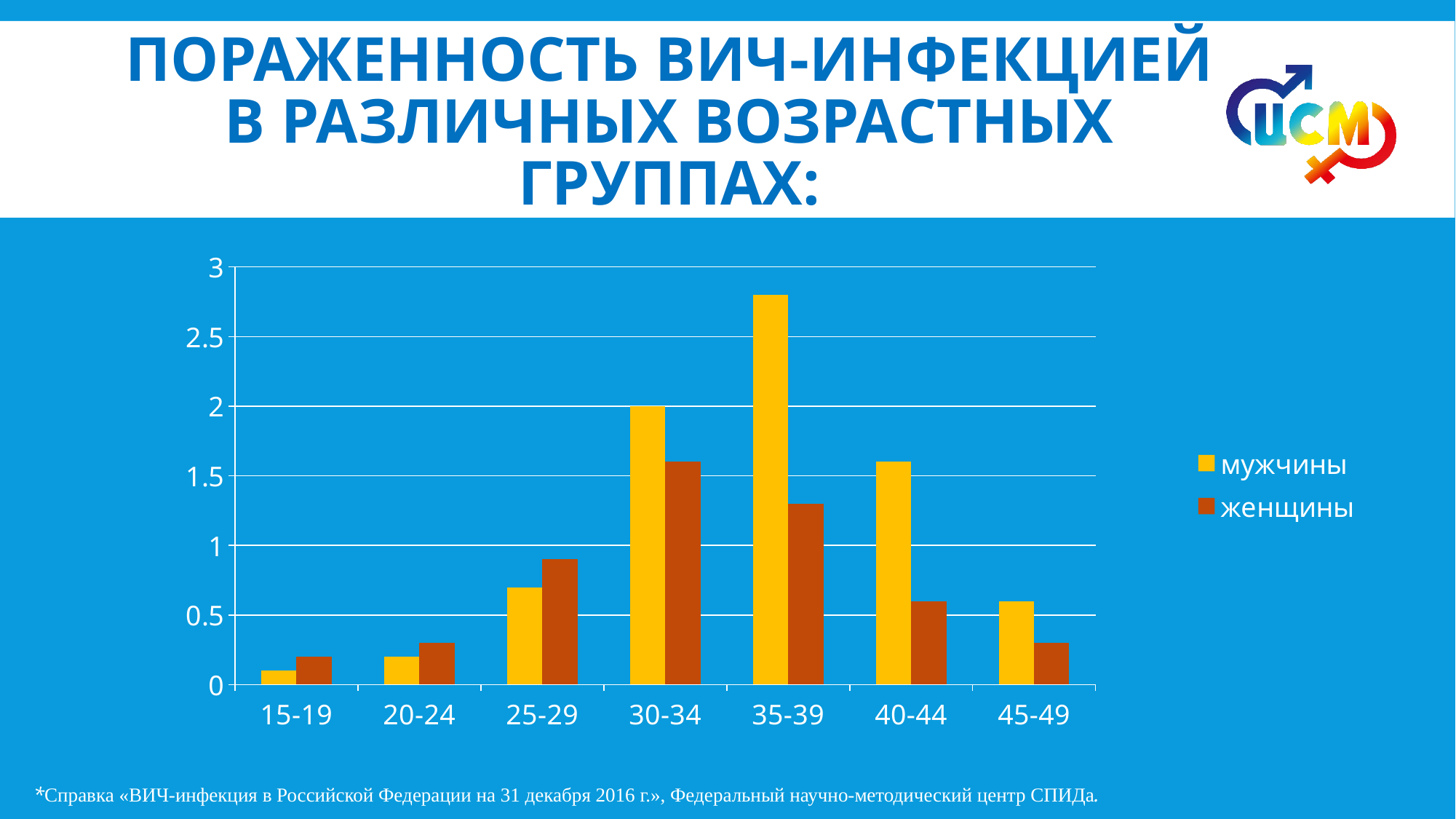
Which age group has the highest value for женщины? 30-34 Which age group has the lowest value for мужчины? 15-19 Is the value for женщины in the 25-29 age group greater or less than 1? less What kind of chart is shown on the slide? bar chart How many series does the legend list? 2 How many age groups are shown on the x axis? 7 In the 25-29 age group, which series has the larger value, мужчины or женщины? женщины What is the value for мужчины in the 30-34 age group? 2 Is the value for мужчины in the 35-39 age group greater or less than 2.5? greater Which age group has the highest value for мужчины? 35-39 Is the value for женщины in the 30-34 age group greater or less than 1.5? greater Which series is shown in yellow? мужчины